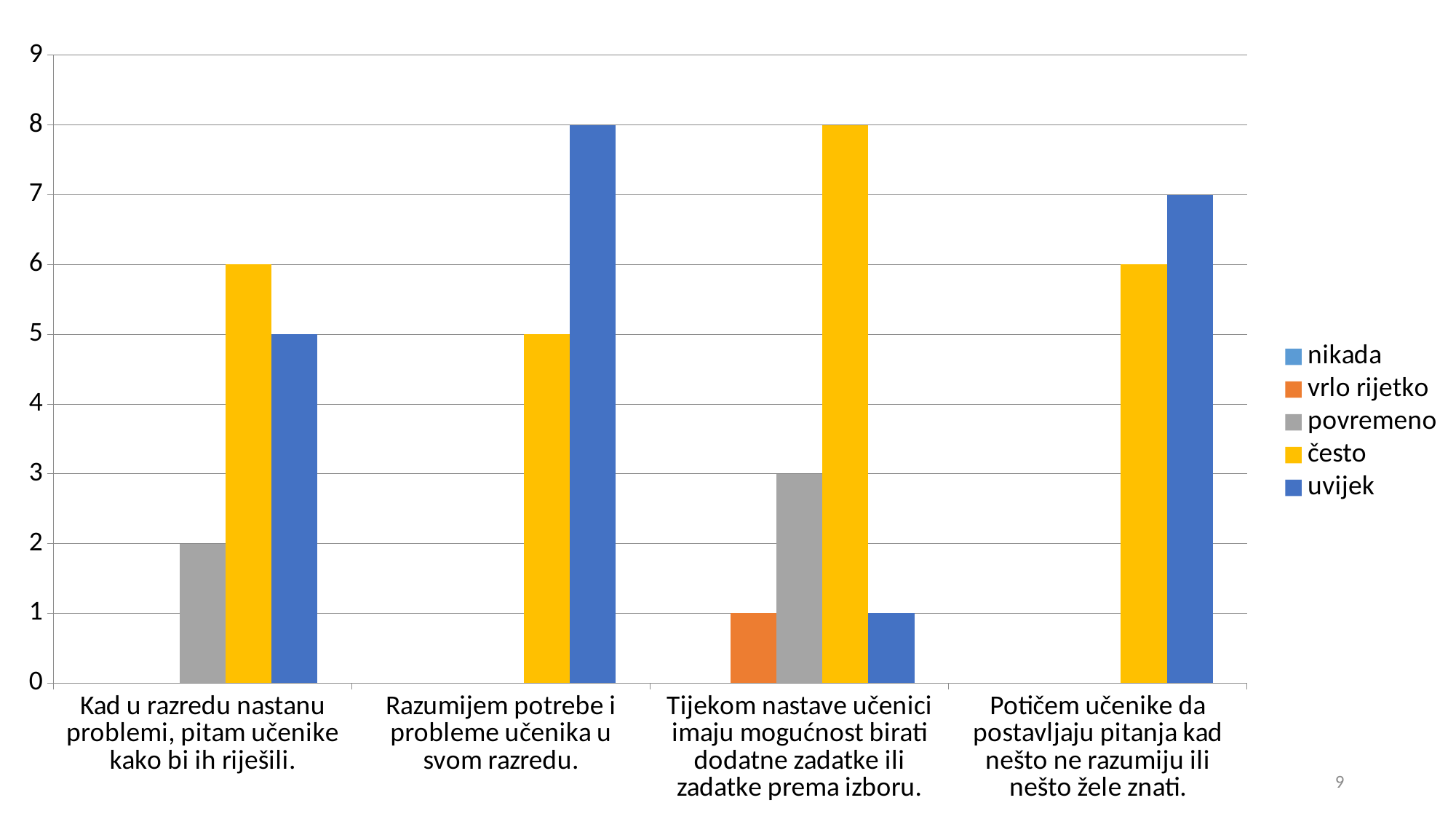
Is the value of "uvijek" for "Potičem učenike da postavljaju pitanja kad nešto ne razumiju ili nešto žele znati." greater or less than 6? greater What is the difference between "uvijek" and "često" for "Potičem učenike da postavljaju pitanja kad nešto ne razumiju ili nešto žele znati."? 1 What type of chart is shown on the slide? bar chart For "Razumijem potrebe i probleme učenika u svom razredu.", which is larger: "često" or "uvijek"? uvijek How many series does the legend list? 5 Which series is shown in orange in the legend? vrlo rijetko Which series has the highest value for "Tijekom nastave učenici imaju mogućnost birati dodatne zadatke ili zadatke prema izboru."? često How many categories are shown on the x axis? 4 What is the value of "povremeno" for "Tijekom nastave učenici imaju mogućnost birati dodatne zadatke ili zadatke prema izboru."? 3 What is the value of "često" for "Kad u razredu nastanu problemi, pitam učenike kako bi ih riješili."? 6 What is the value of "uvijek" for "Razumijem potrebe i probleme učenika u svom razredu."? 8 Which series has the lowest value for "Kad u razredu nastanu problemi, pitam učenike kako bi ih riješili." among the bars shown? povremeno